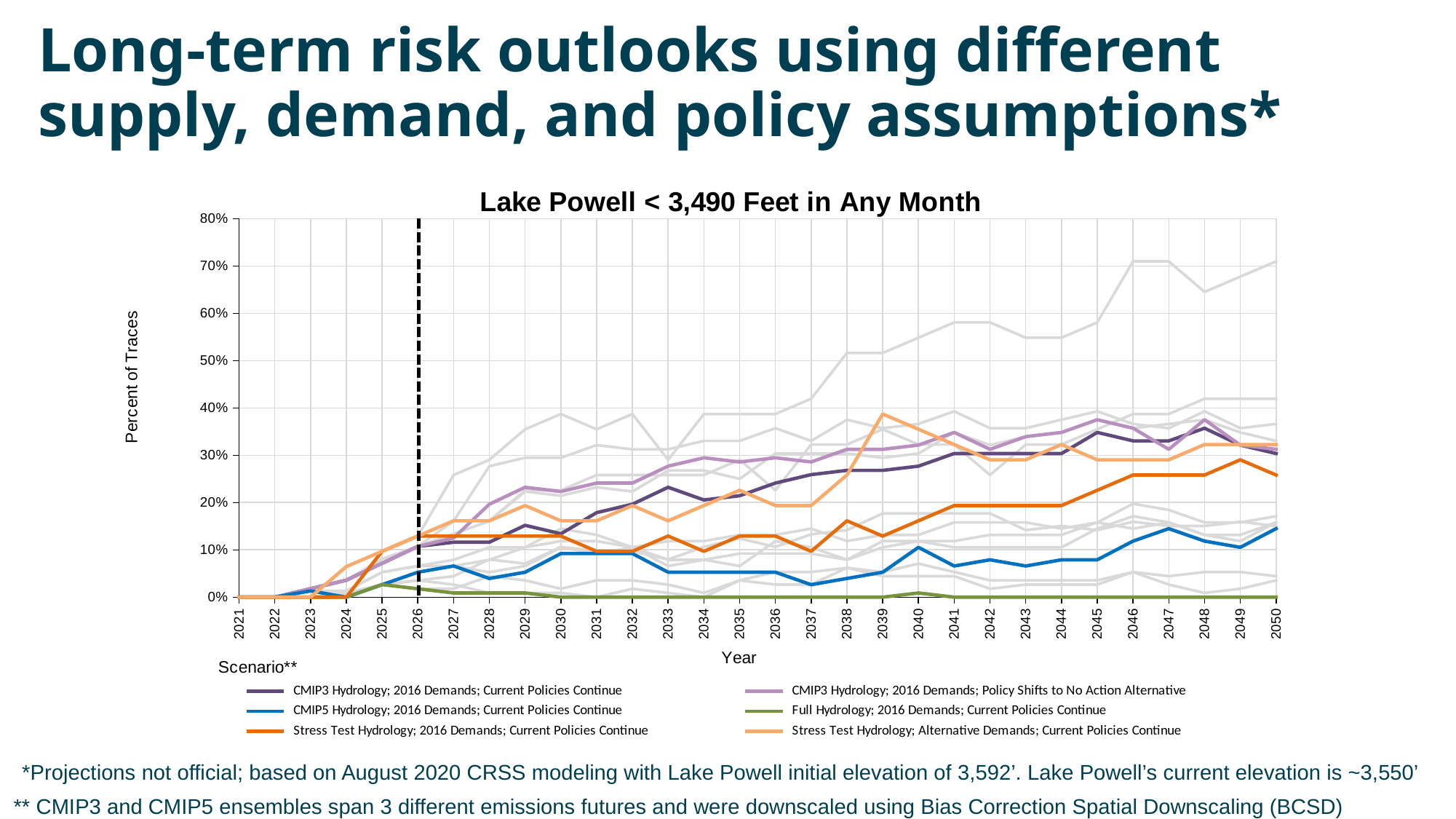
What is the label of the y axis? Percent of Traces Does the 'CMIP3 Hydrology; 2016 Demands; Current Policies Continue' series generally rise or fall from 2021 to 2050? rise In 2040, which is larger: 'CMIP3 Hydrology; 2016 Demands; Policy Shifts to No Action Alternative' or 'CMIP5 Hydrology; 2016 Demands; Current Policies Continue'? CMIP3 Hydrology; 2016 Demands; Policy Shifts to No Action Alternative Is the value for 'CMIP5 Hydrology; 2016 Demands; Current Policies Continue' in 2050 greater or less than 10%? greater What kind of chart is shown on the slide? line chart How many series does the legend list? 6 What is the title of the chart? Lake Powell < 3,490 Feet in Any Month Which legend series has the lowest value in 2050? Full Hydrology; 2016 Demands; Current Policies Continue Is the value for 'Full Hydrology; 2016 Demands; Current Policies Continue' in 2050 greater or less than 10%? less Is the value for 'Stress Test Hydrology; Alternative Demands; Current Policies Continue' in 2039 greater or less than 30%? greater How many years are plotted along the x axis? 30